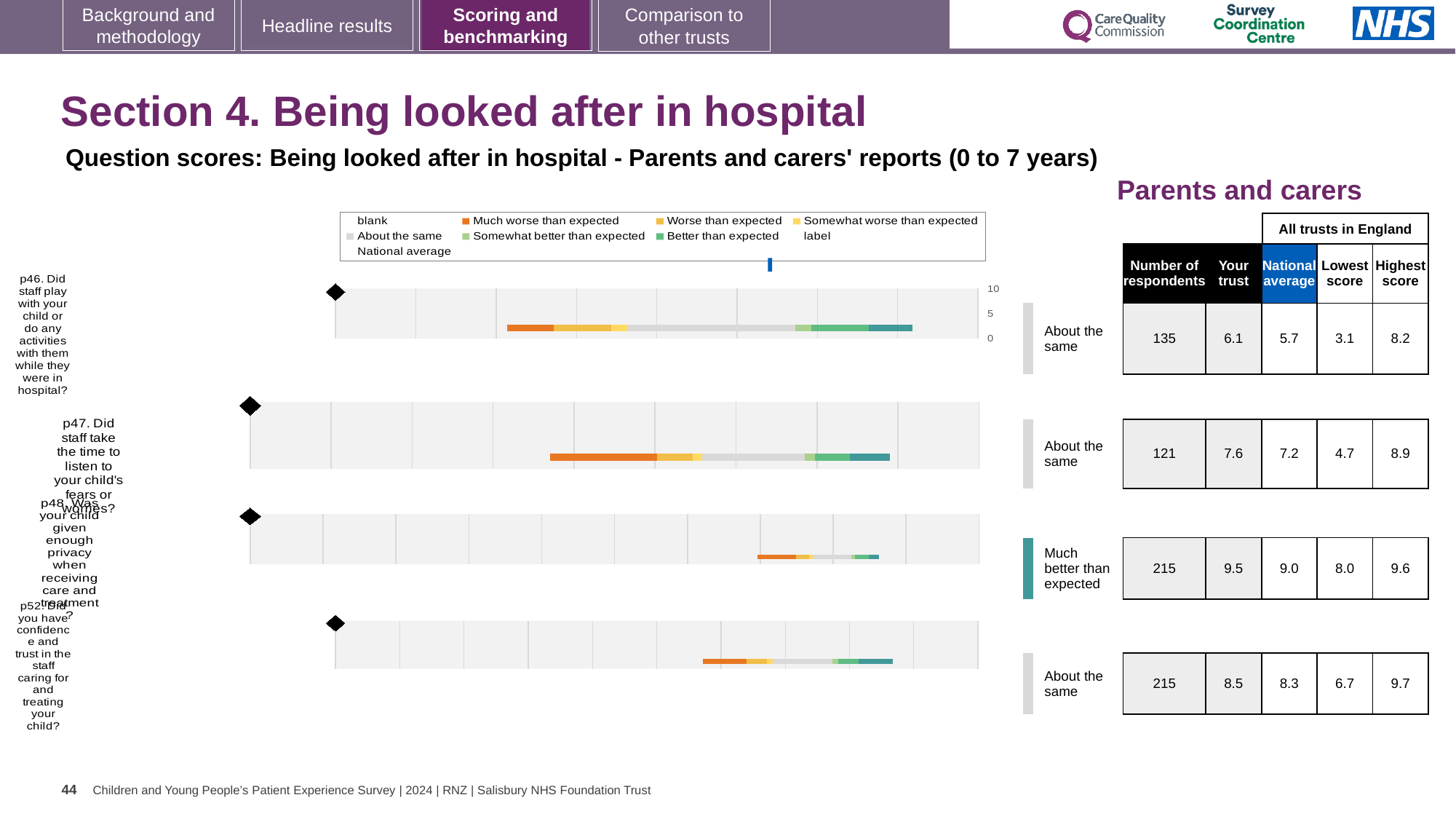
What is the heading shown above the results table on the right of the slide? Parents and carers For question p47, how much higher is the 'Your trust' score than the national average? 0.4 For question p48 (Was your child given enough privacy), what is the national average score? 9.0 How many survey questions (rows of bars) are plotted on the slide? 4 Which question has the lowest 'Your trust' score? p46 For question p47 (Did staff take the time to listen to your child's fears or worries), what is the 'Your trust' score? 7.6 For question p52, which is larger: the 'Your trust' score or the national average? Your trust Which question has the highest 'Your trust' score? p48 What kind of chart is used to show the question scores on this slide? Bar chart Which question is rated 'Much better than expected'? p48 For question p52 (Did you have confidence and trust in the staff), what is the highest score among all trusts in England? 9.7 For question p46 (Did staff play with your child or do any activities with them), what is the number of respondents? 135